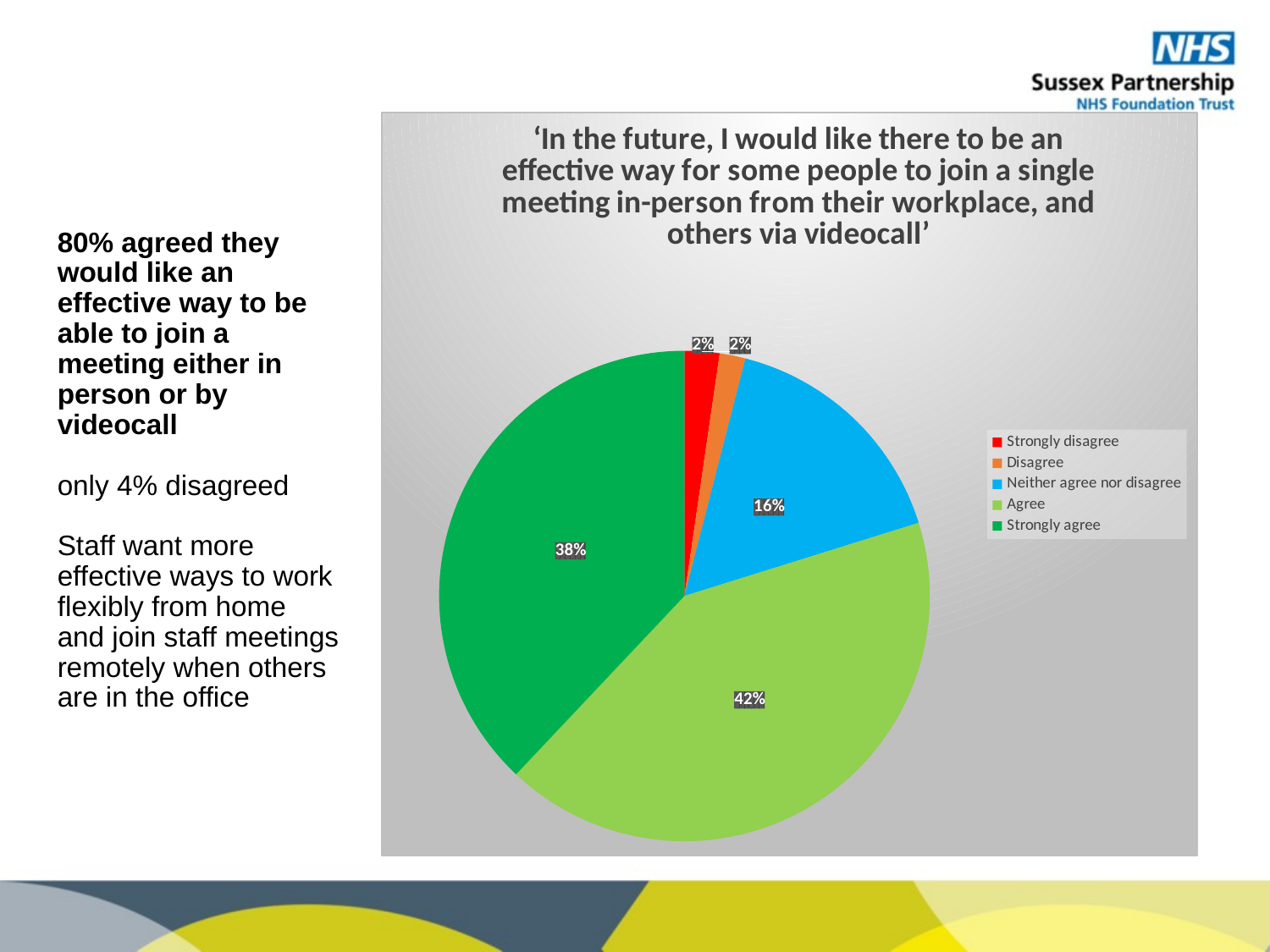
What kind of chart is shown on the slide? Pie chart What percentage of respondents chose 'Strongly disagree'? 2% What percentage of respondents chose 'Strongly agree'? 38% Which is larger, the share for 'Agree' or the share for 'Strongly agree'? Agree What percentage of respondents chose 'Agree'? 42% How many entries does the legend list? 5 How many slices does the pie chart have? 5 Which response category has the largest share of the pie? Agree What is the difference in percentage points between 'Agree' and 'Strongly agree'? 4 What is the combined share of 'Agree' and 'Strongly agree'? 80% What percentage of respondents chose 'Neither agree nor disagree'? 16% What colour is the 'Neither agree nor disagree' slice? Blue